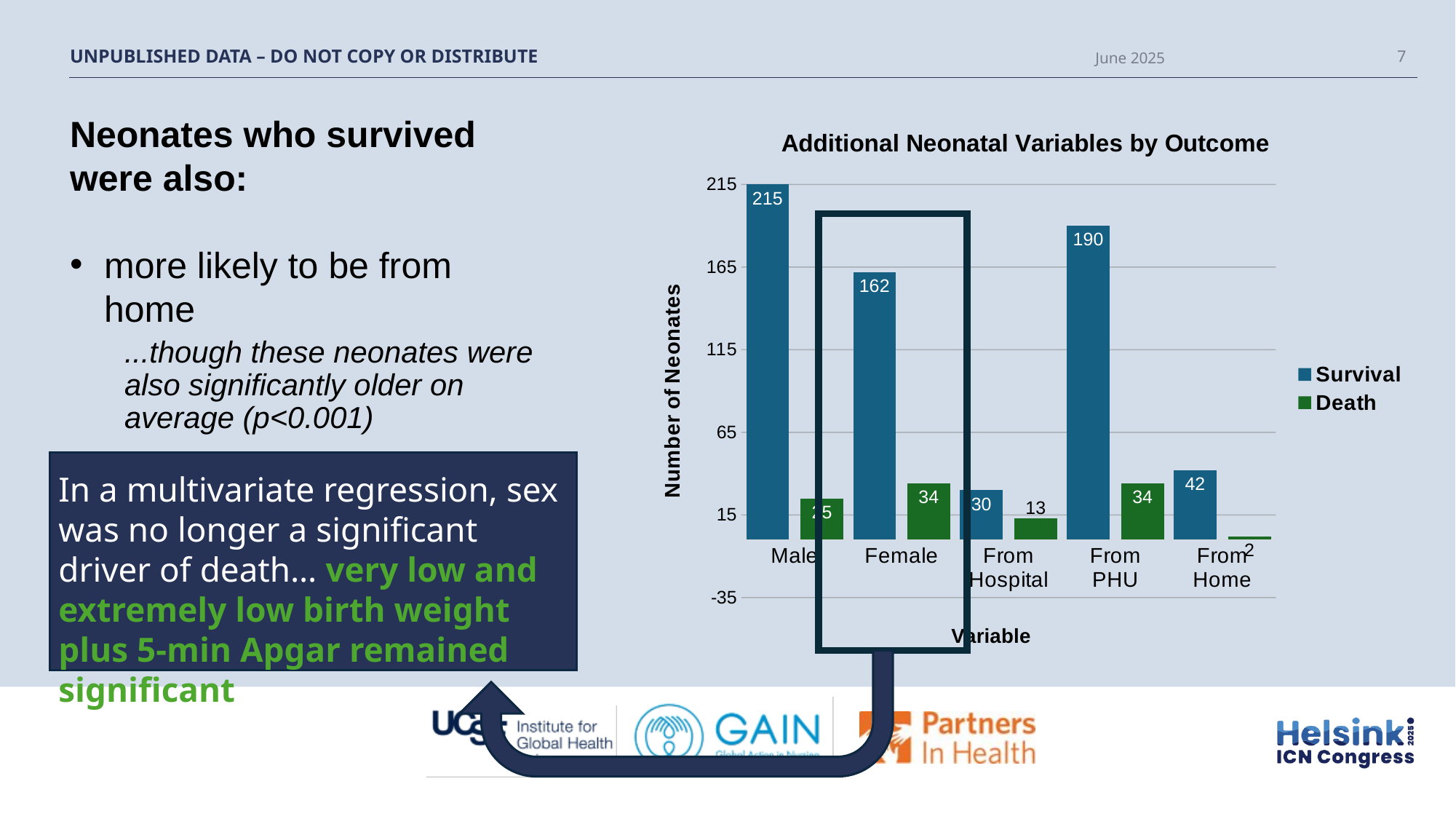
What is the Survival value for From PHU? 190 What is the difference between the Survival values for Male and Female? 53 How many categories are shown on the x axis of the chart? 5 Which category has the highest Survival value? Male Which is larger, the Survival value for From Hospital or the Survival value for From Home? From Home Which category has the lowest Death value? From Home What is the Death value for From Hospital? 13 What is the Death value for From Home? 2 What type of chart is shown on the slide? bar chart How many series does the chart legend list? 2 What is the Survival value for Female? 162 What is the title of the chart? Additional Neonatal Variables by Outcome